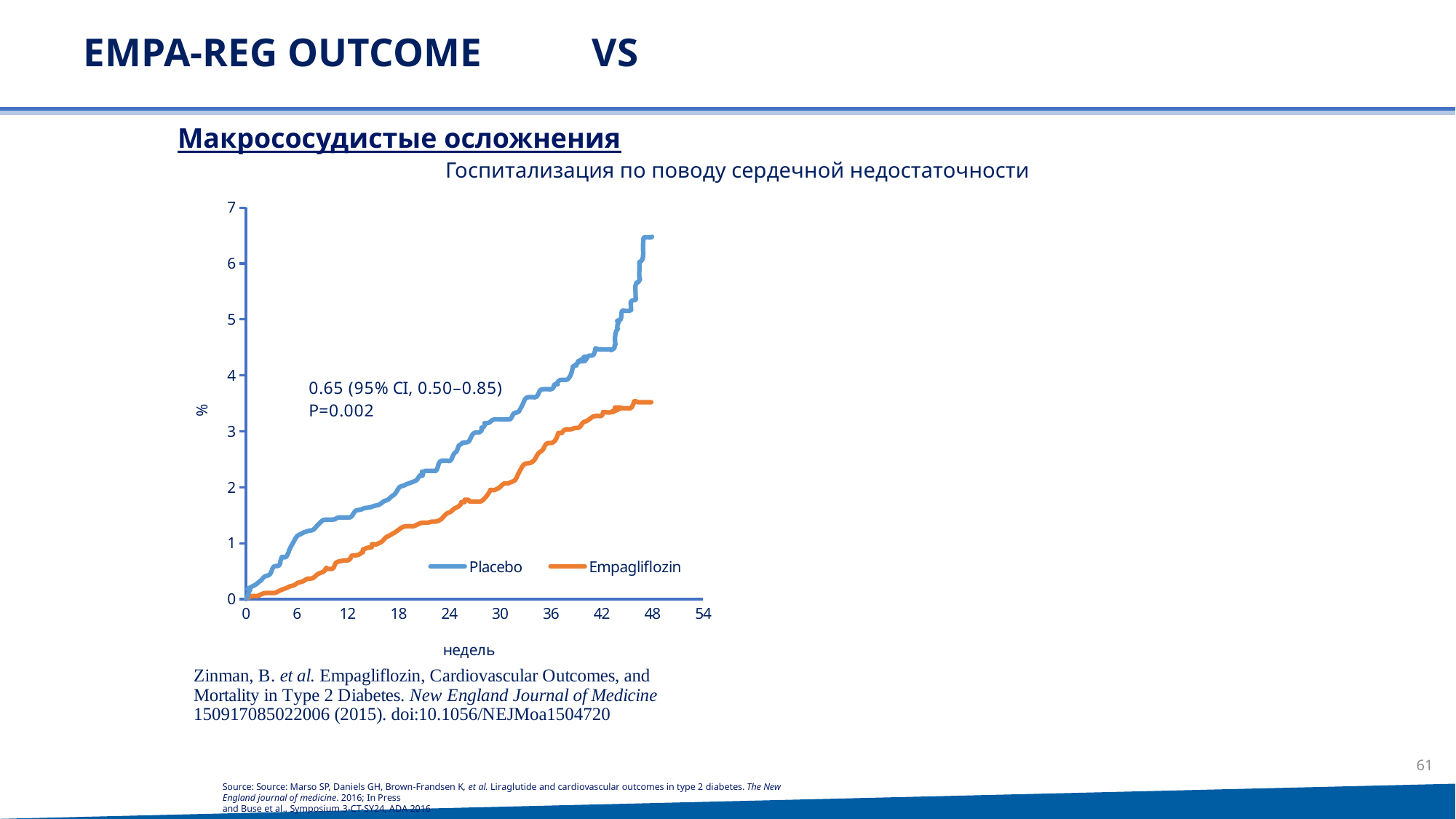
How many series does the legend of the chart list? 2 What kind of chart is shown on the slide? line chart Is the value for Empagliflozin at week 48 greater or less than 4? less What P value is printed on the chart? P=0.002 Is the value for Placebo at week 48 greater or less than 6? greater Is the value for Placebo at week 24 greater or less than 2? greater Which two series are listed in the chart legend? Placebo and Empagliflozin What is the title of the chart? Госпитализация по поводу сердечной недостаточности Which series has the higher value at week 48, Placebo or Empagliflozin? Placebo Do the values for Placebo rise or fall as the weeks increase along the x axis? rise